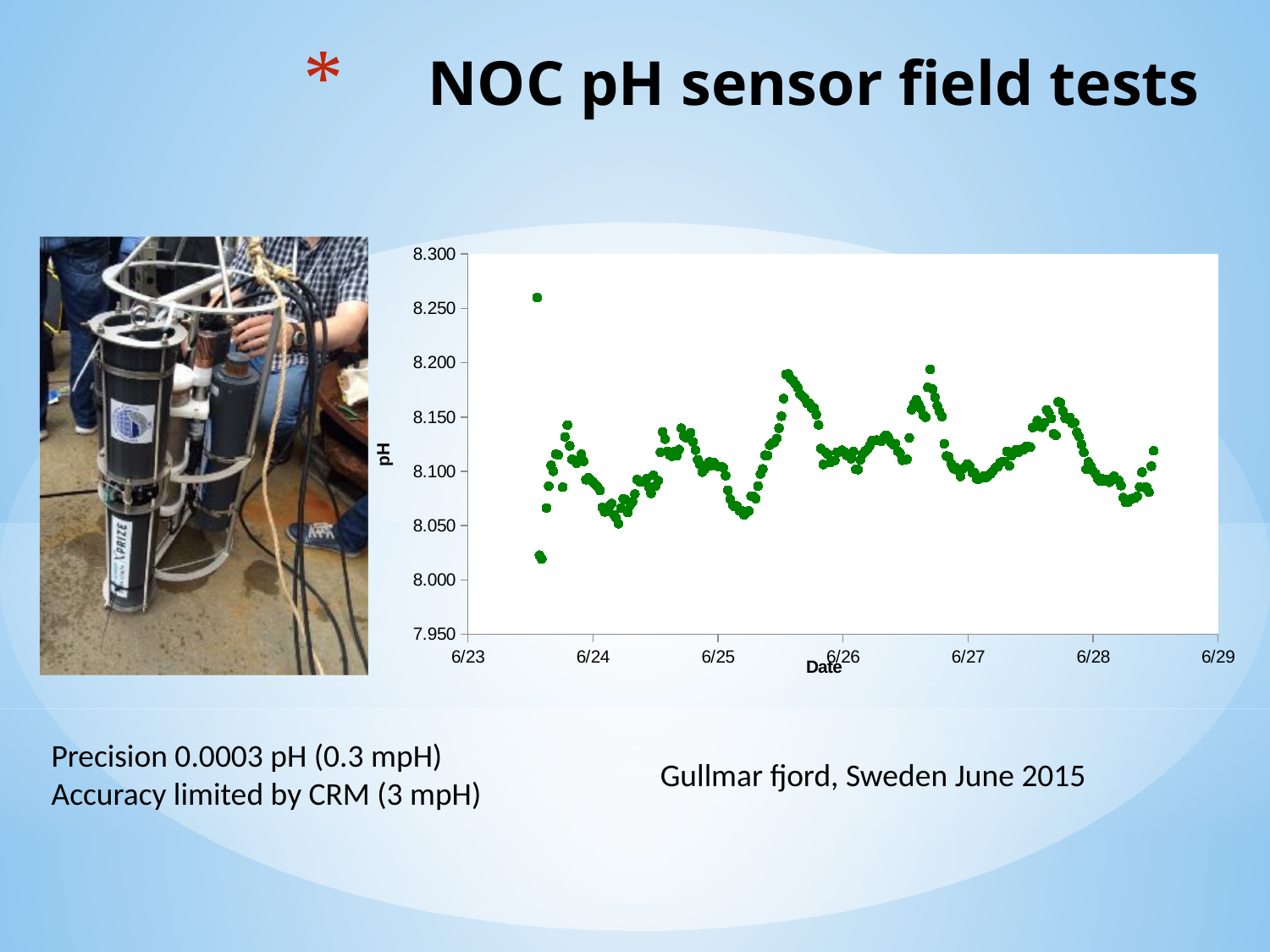
What kind of chart is shown on the slide? scatter chart Is the lowest pH value plotted on the chart greater or less than 8.050? less Is the peak pH value plotted between 6/25 and 6/26 greater or less than 8.150? greater Are the pH values plotted just after 6/28 greater or less than 8.150? less What is the label of the y axis of the chart? pH What is the label of the x axis of the chart? Date